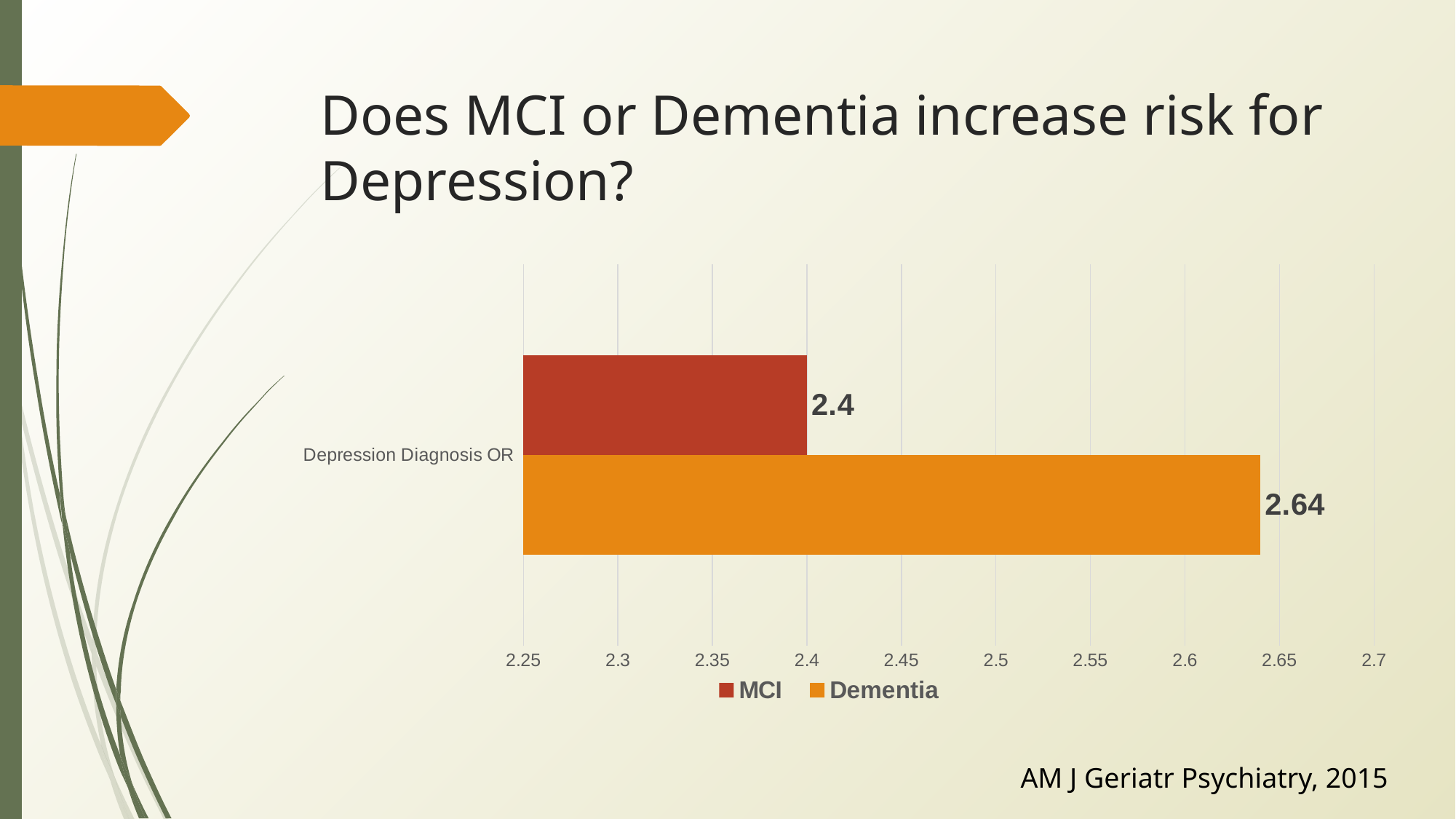
What is the Depression Diagnosis OR value for Dementia? 2.64 Is the value for Dementia greater or less than 2.5? greater Which series has the higher Depression Diagnosis OR, MCI or Dementia? Dementia What colour is the bar for Dementia? orange How many series does the legend list? 2 What kind of chart is shown on the slide? bar chart Is the value for MCI greater or less than 2.5? less Is the Dementia value larger or smaller than the MCI value? larger What is the Depression Diagnosis OR value for MCI? 2.4 Which series has the lower Depression Diagnosis OR? MCI What is the difference between the Dementia and MCI Depression Diagnosis OR values? 0.24 How many categories are shown on the vertical axis of the chart? 1